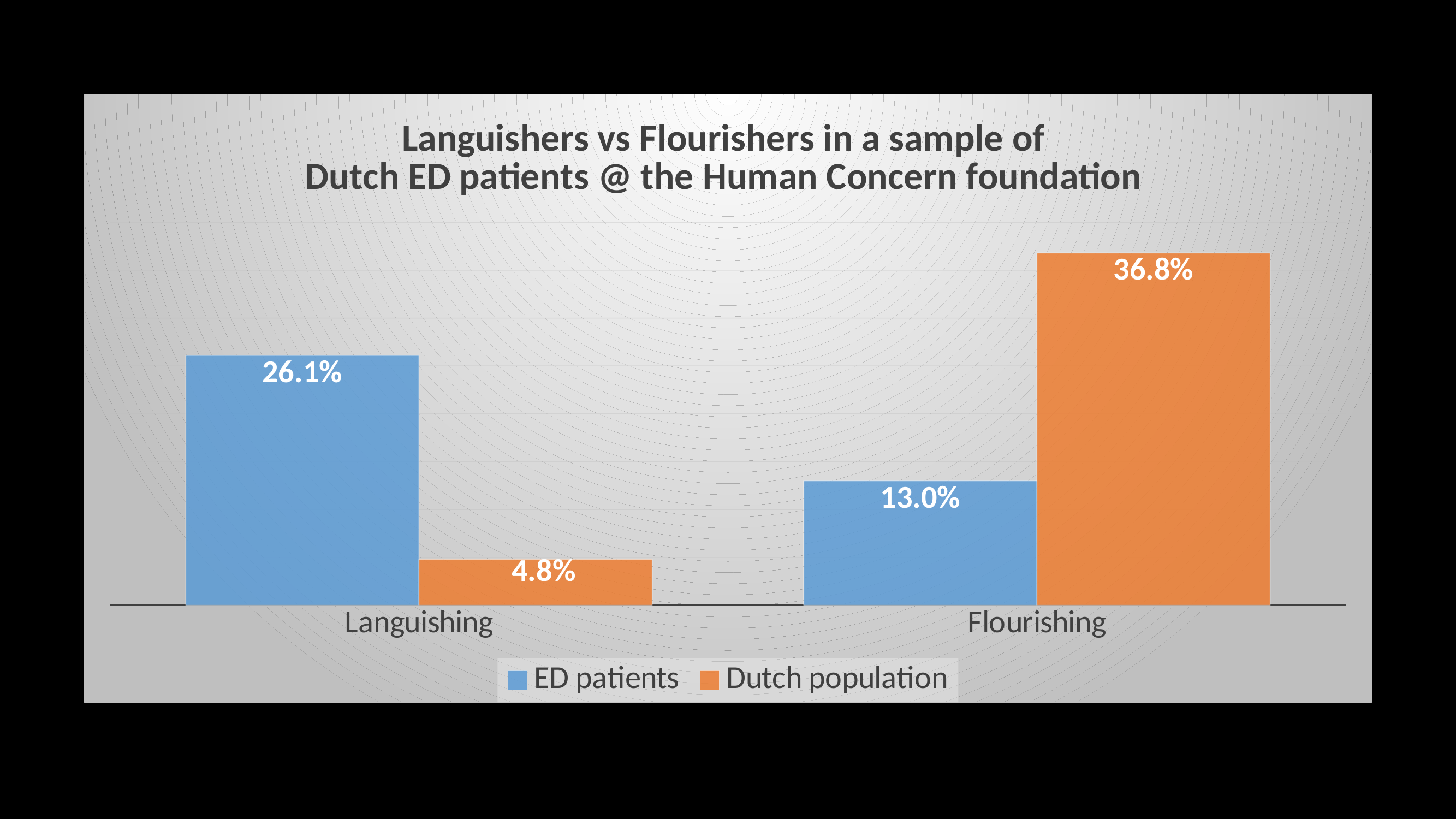
What is the difference between the ED patients and Dutch population values in the Languishing category? 21.3% What is the value for the Dutch population in the Flourishing category? 36.8% What kind of chart is shown on the slide? Bar chart Which bar has the highest value on the chart? Dutch population, Flourishing What is the value for ED patients in the Languishing category? 26.1% How many series does the legend list? 2 What is the difference between the Dutch population and ED patients values in the Flourishing category? 23.8% Which bar has the lowest value on the chart? Dutch population, Languishing How many categories are shown on the x axis? 2 What is the value for ED patients in the Flourishing category? 13.0% In the Flourishing category, which series has the larger value: ED patients or Dutch population? Dutch population What is the value for the Dutch population in the Languishing category? 4.8%